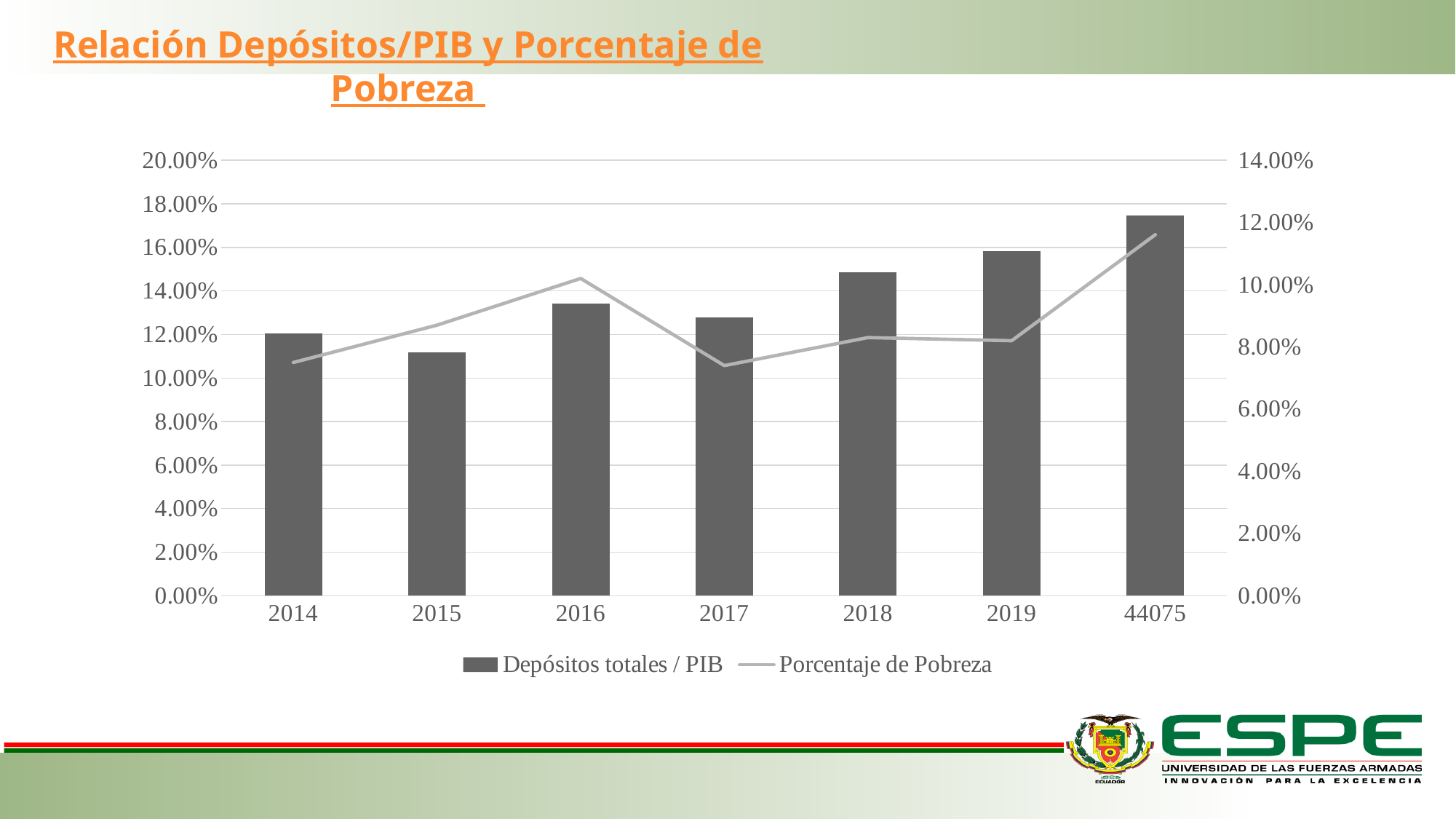
Does the Porcentaje de Pobreza line rise or fall from 2016 to 2017? fall Is the Depósitos totales / PIB bar for 2019 greater or less than 14.00%? greater What is the title of the chart on the slide? Relación Depósitos/PIB y Porcentaje de Pobreza Is the Porcentaje de Pobreza value for 2016 greater or less than 10.00% on the right axis? greater Is the Depósitos totales / PIB bar for 2015 greater or less than 12.00%? less How many categories are shown on the x axis of the chart? 7 Which year has the highest point on the Porcentaje de Pobreza line? 44075 Which is larger, the Depósitos totales / PIB bar for 2016 or for 2017? 2016 How many series does the chart's legend list? 2 Which category has the shortest bar for Depósitos totales / PIB? 2015 Which category has the tallest bar for Depósitos totales / PIB? 44075